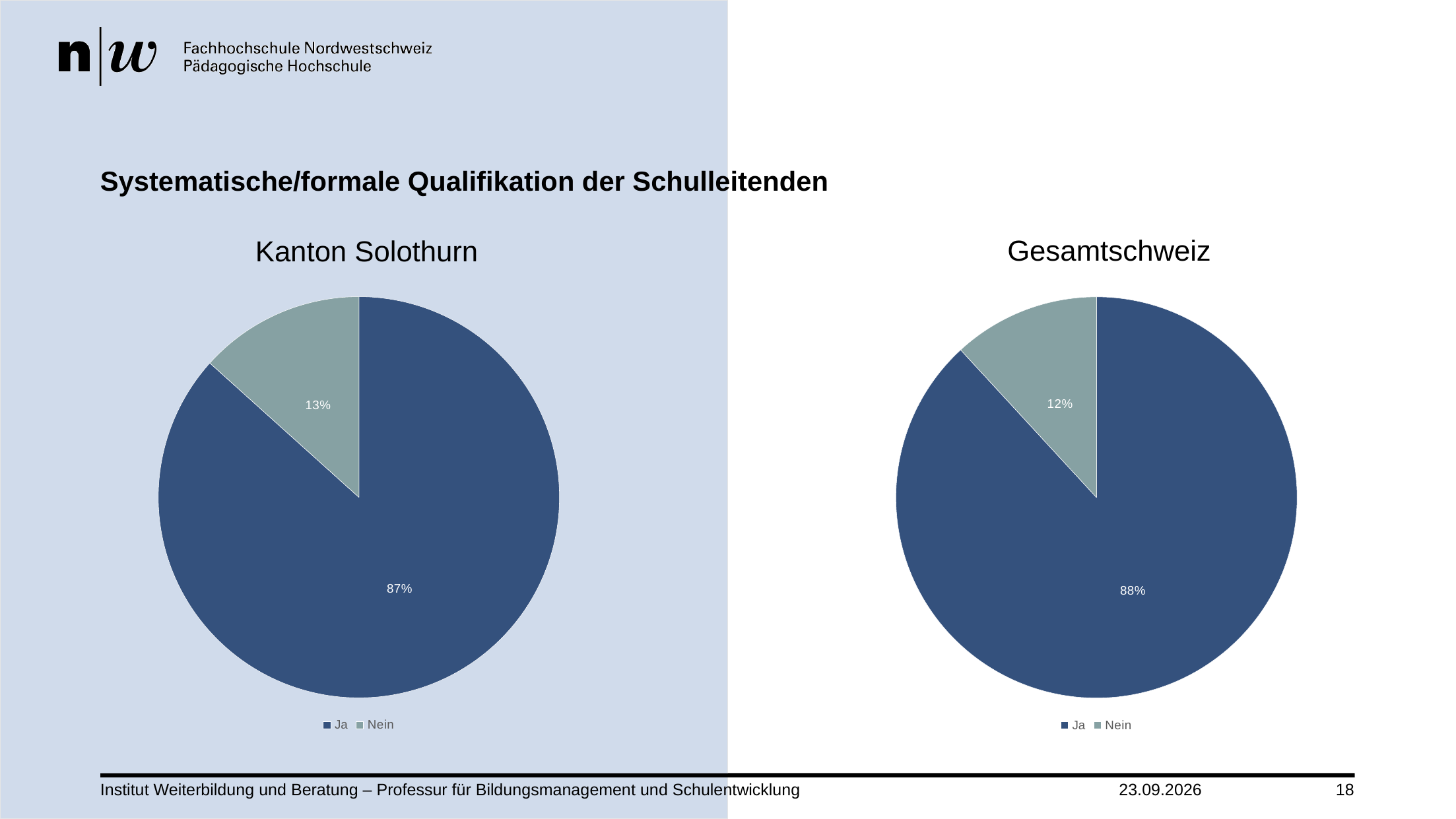
In the Gesamtschweiz chart, what is the difference in percentage points between the Ja and Nein slices? 76 In the Gesamtschweiz chart, what share is labelled for Ja? 88% What kind of chart is the Kanton Solothurn chart? Pie chart In the Gesamtschweiz chart, what share is labelled for Nein? 12% In the Kanton Solothurn chart, what is the difference in percentage points between the Ja and Nein slices? 74 What is the title of the chart on the right side of the slide? Gesamtschweiz How many slices does the Gesamtschweiz pie chart have? 2 How many entries does the legend of the Kanton Solothurn chart list? 2 In the Kanton Solothurn chart, what share is labelled for Nein? 13% In the Kanton Solothurn chart, which slice is the largest? Ja In the Kanton Solothurn chart, what share is labelled for Ja? 87% In the Gesamtschweiz chart, which slice is the smallest? Nein